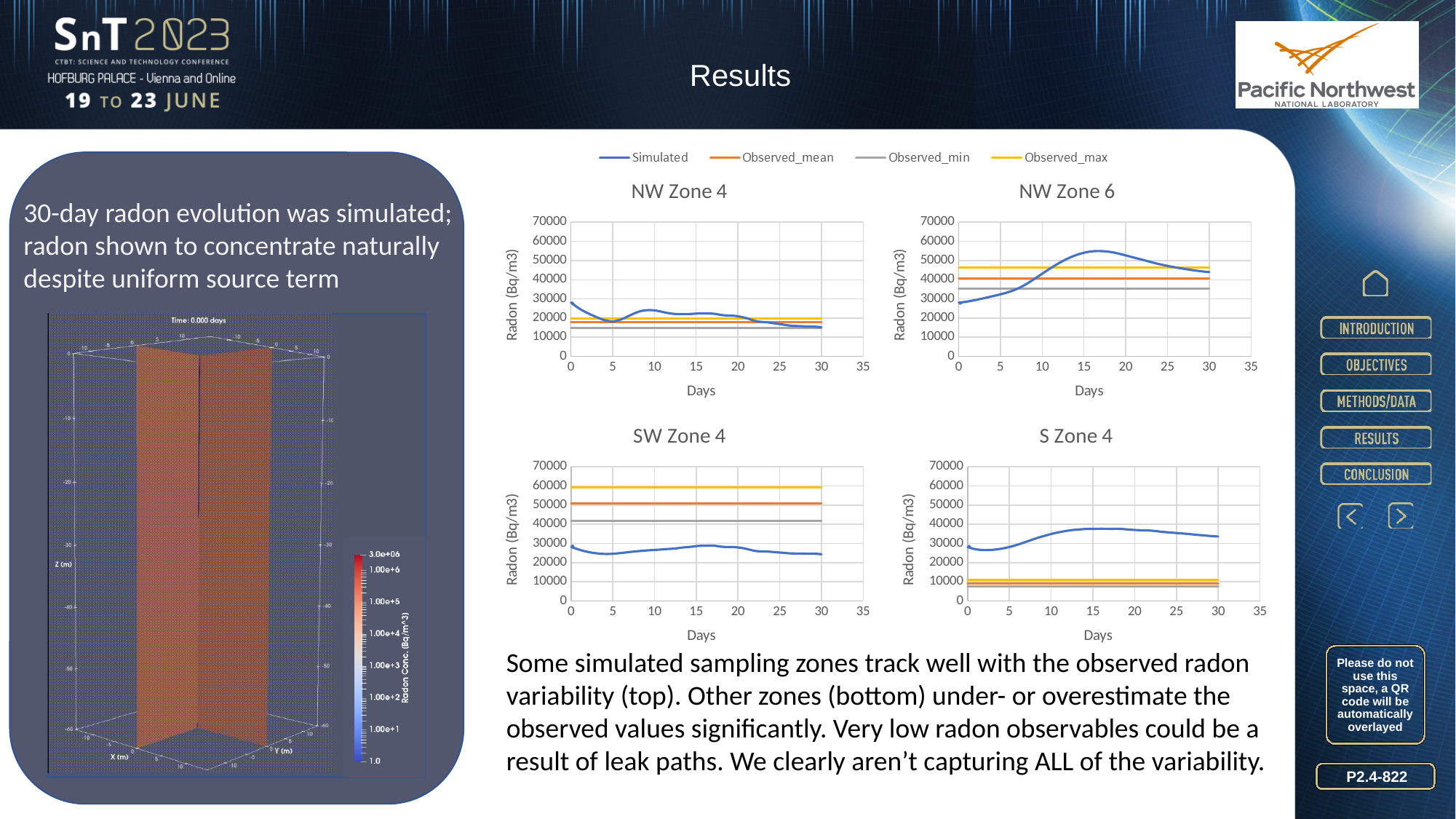
What is the y-axis label on the SW Zone 4 chart? Radon (Bq/m3) In the SW Zone 4 chart, is the Observed_max value greater or less than 50000? greater How many series does the shared legend above the charts list? 4 In the NW Zone 4 chart, is the Observed_min value greater or less than 20000? less In the S Zone 4 chart, is the Observed_max value greater or less than 20000? less How many line charts are shown on the slide? 4 In the S Zone 4 chart, which is higher, the Simulated line or the Observed_max line? Simulated What are the four series named in the legend above the charts? Simulated, Observed_mean, Observed_min, Observed_max What kind of chart is the NW Zone 4 chart? line chart In the NW Zone 6 chart, does the Simulated line rise or fall between day 0 and day 15? rise In the SW Zone 4 chart, which is higher, the Observed_max line or the Simulated line? Observed_max